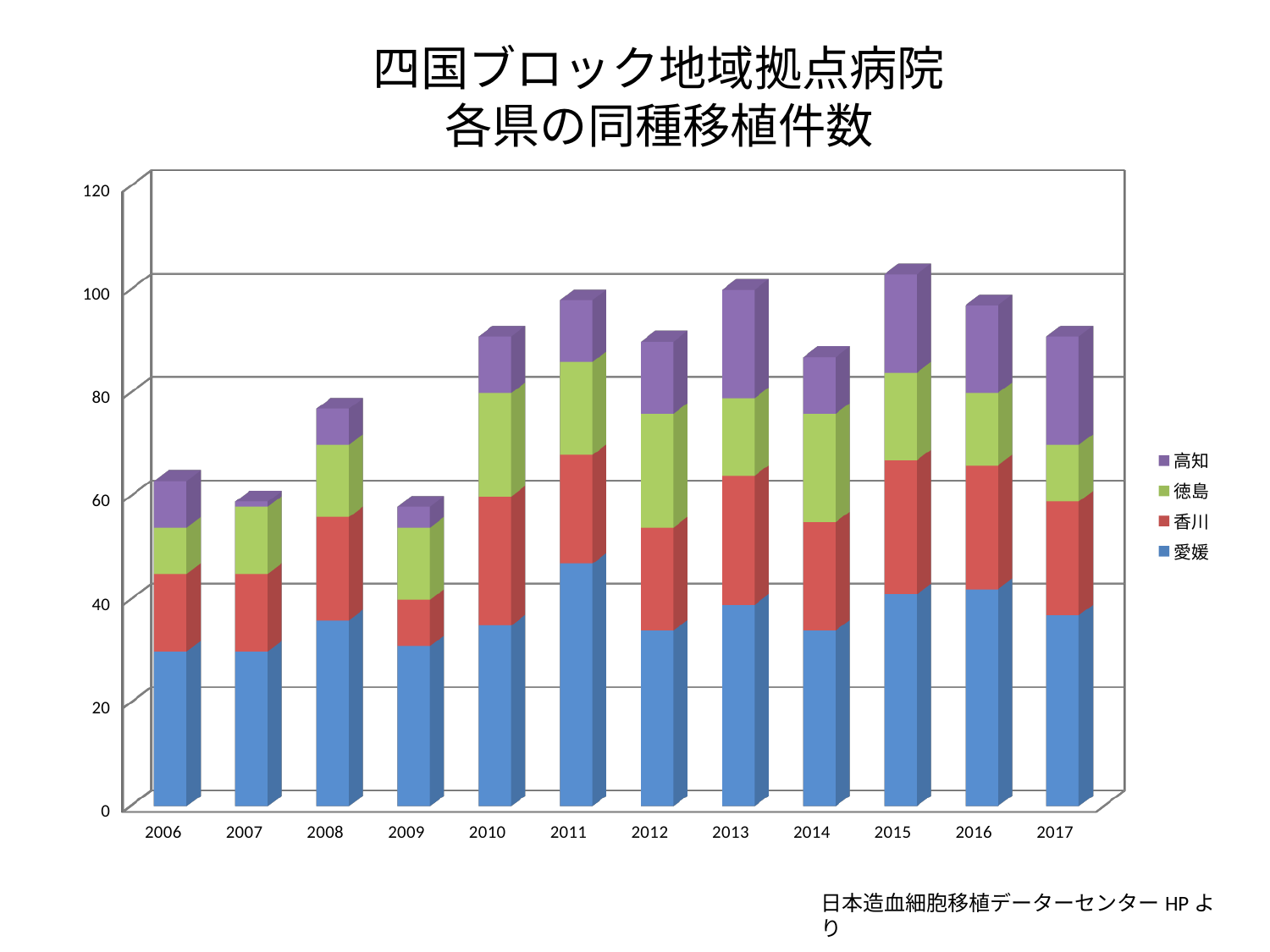
Which year has the larger total, 2008 or 2010? 2010 Do the total values rise or fall from 2009 to 2011? rise Which series is shown at the bottom of each stacked bar? 愛媛 Is the 愛媛 value for 2011 greater or less than 40? greater How many years (categories) are shown on the x axis? 12 What kind of chart is shown on the slide? stacked bar chart Is the total for 2010 greater or less than 80? greater Is the total for 2015 greater or less than 100? greater Which year has the larger total, 2016 or 2017? 2016 Which year has the highest total stacked bar? 2015 How many series does the legend list? 4